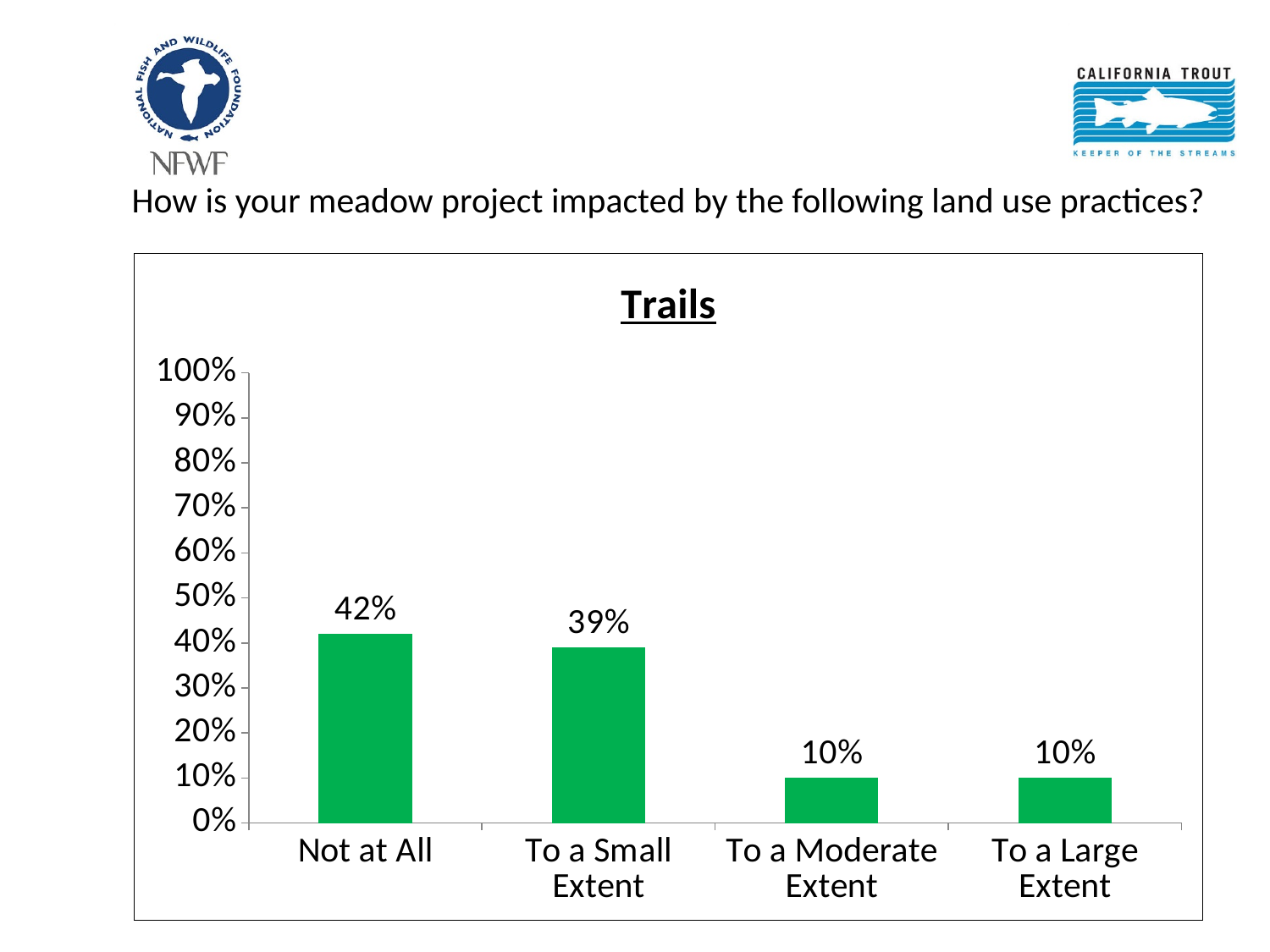
How many categories are shown on the x axis? 4 What is the title of the chart? Trails What is the value for "To a Moderate Extent"? 10% What is the difference between the values for "To a Small Extent" and "To a Moderate Extent"? 29% What is the difference between the values for "Not at All" and "To a Small Extent"? 3% Which is larger, the value for "Not at All" or the value for "To a Large Extent"? Not at All Is the value for "To a Small Extent" greater or less than 50%? less What is the value for "To a Small Extent"? 39% What is the value for "To a Large Extent"? 10% What kind of chart is shown on the slide? bar chart What is the value for "Not at All"? 42% Which category has the highest value? Not at All